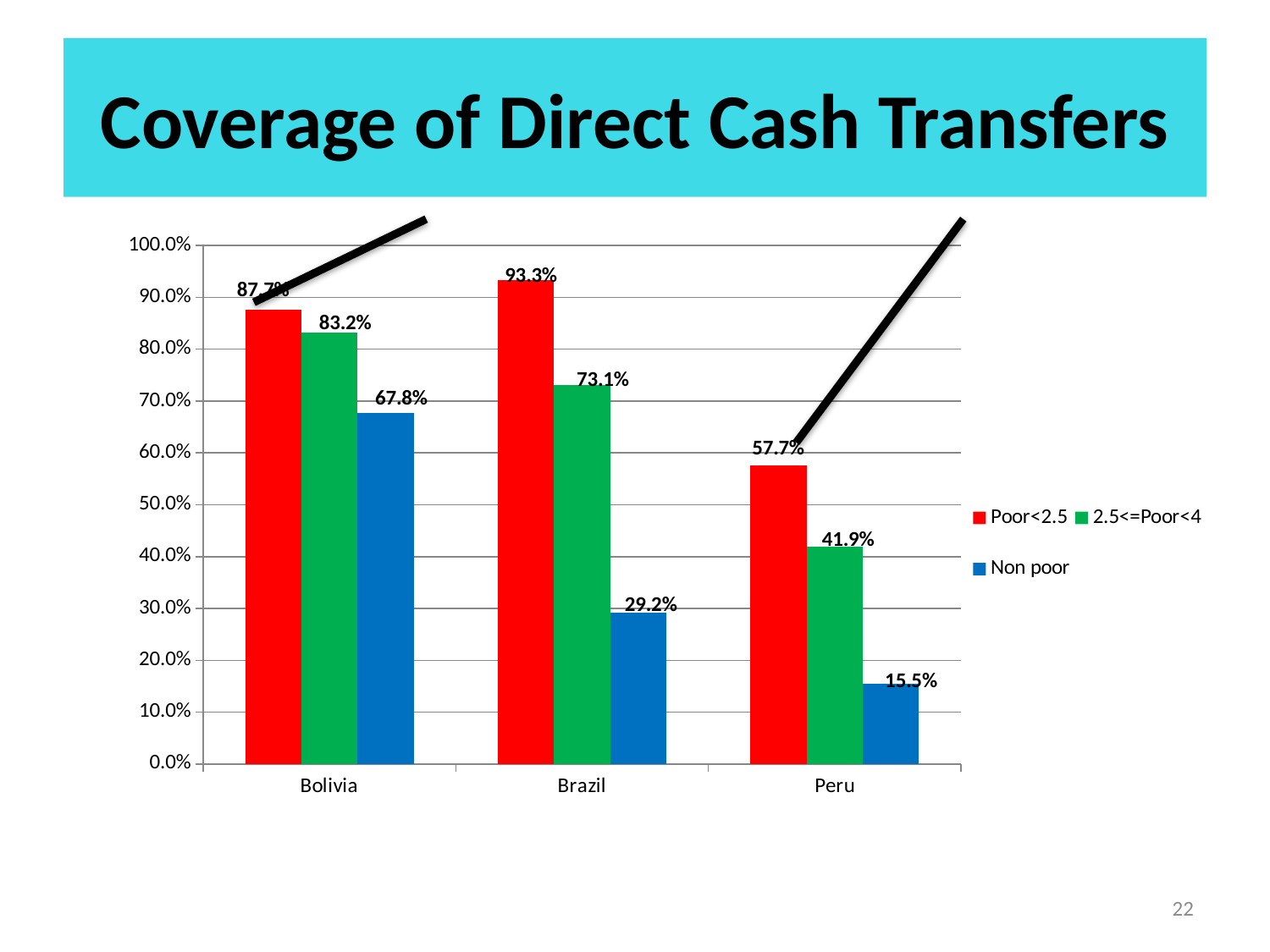
What is the value for the Non poor series in Peru? 15.5% How many series does the legend list? 3 How many countries are shown on the x axis? 3 What is the value for the Poor<2.5 series in Peru? 57.7% Which is larger: the 2.5<=Poor<4 value in Brazil or the Non poor value in Bolivia? 2.5<=Poor<4 value in Brazil What is the difference between the Poor<2.5 and Non poor values in Brazil? 64.1% Which country has the highest value for the Poor<2.5 series? Brazil Which country has the lowest value for the Non poor series? Peru What kind of chart is shown on the slide? Bar chart Is the value for the Poor<2.5 series in Bolivia greater or less than 80.0%? greater What is the value for the 2.5<=Poor<4 series in Bolivia? 83.2% What is the value for the Non poor series in Brazil? 29.2%